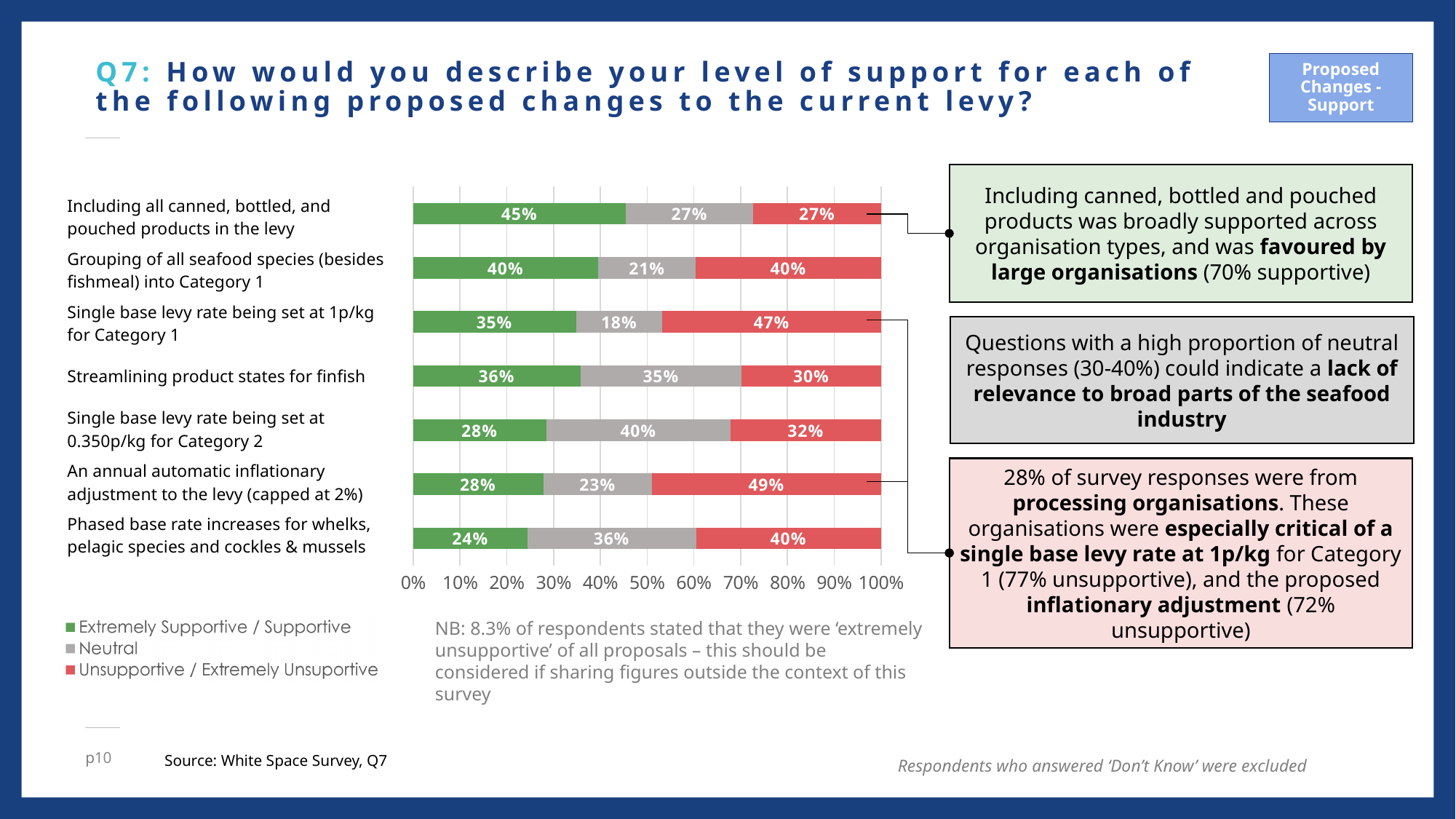
What percentage of respondents were Neutral on the single base levy rate being set at 0.350p/kg for Category 2? 40% Which is larger for streamlining product states for finfish: the Extremely Supportive / Supportive share or the Unsupportive / Extremely Unsupportive share? Extremely Supportive / Supportive What percentage of respondents were Extremely Supportive / Supportive of including all canned, bottled, and pouched products in the levy? 45% What is the difference between the Unsupportive / Extremely Unsupportive percentage and the Extremely Supportive / Supportive percentage for the single base levy rate being set at 1p/kg for Category 1? 12% Which proposed change has the lowest Neutral percentage? Single base levy rate being set at 1p/kg for Category 1 How many proposed changes are shown in the chart? 7 What kind of chart is shown on the slide? Stacked bar chart What colour represents the Neutral series in the chart? Grey What percentage of respondents were Unsupportive / Extremely Unsupportive of an annual automatic inflationary adjustment to the levy (capped at 2%)? 49% Which proposed change has the highest Extremely Supportive / Supportive percentage? Including all canned, bottled, and pouched products in the levy How many series does the chart legend list? 3 Which proposed change has the lowest Extremely Supportive / Supportive percentage? Phased base rate increases for whelks, pelagic species and cockles & mussels